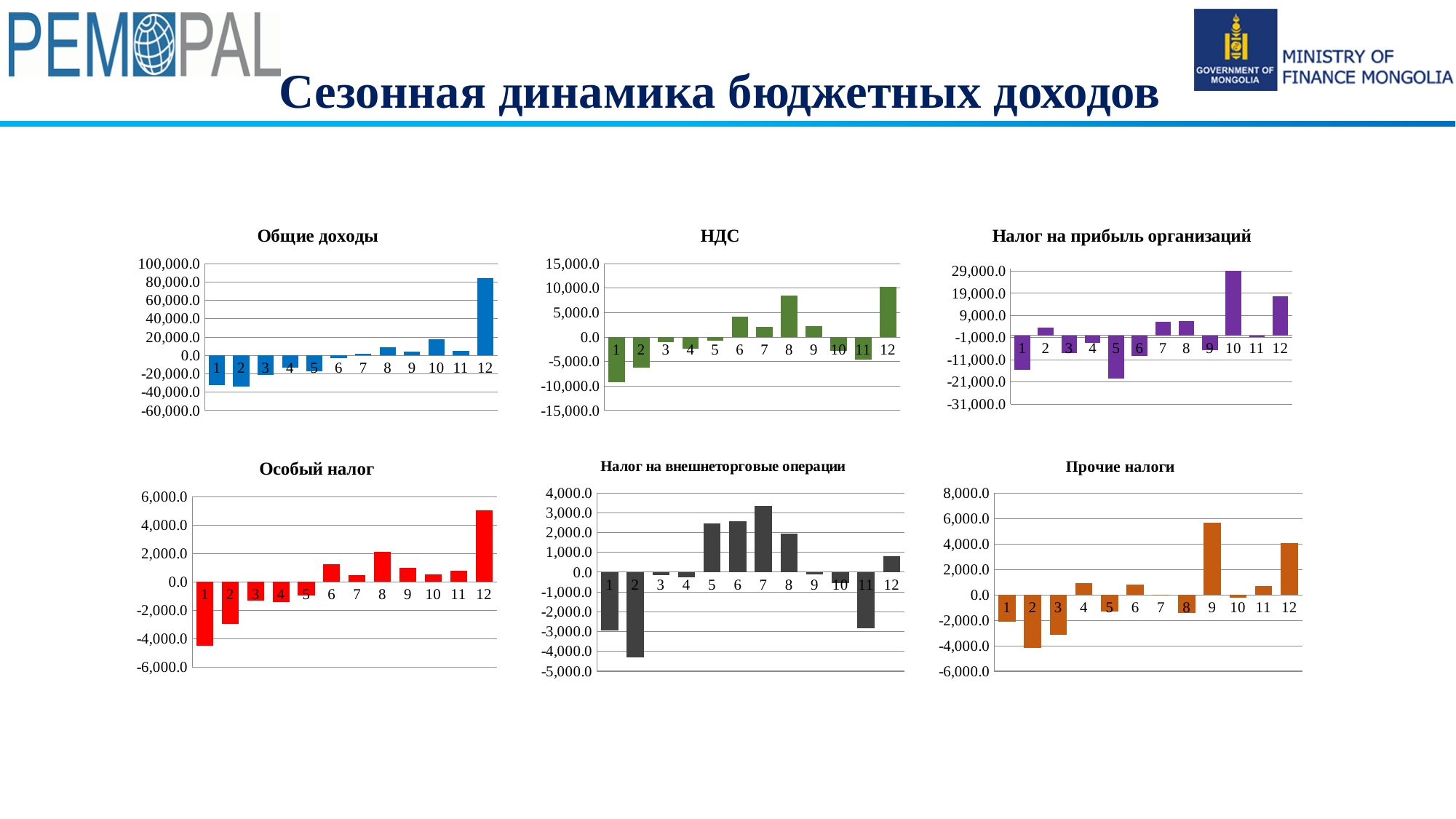
In the 'Налог на прибыль организаций' chart, which category has the highest value? 10 In the 'Налог на внешнеторговые операции' chart, is the value for category 2 greater or less than -4,000.0? less In the 'Налог на внешнеторговые операции' chart, which category has the highest value? 7 In the 'НДС' chart, which category has the lowest value? 1 In the 'Особый налог' chart, is the value for category 12 greater or less than 4,000.0? greater In the 'Налог на прибыль организаций' chart, which category has the lowest value? 5 How many charts are shown on the slide? 6 What kind of chart is the 'Общие доходы' chart? bar chart How many categories are shown on the x axis of the 'НДС' chart? 12 In the 'Прочие налоги' chart, is the value for category 9 greater or less than 4,000.0? greater In the 'Прочие налоги' chart, which is larger, the value for category 9 or category 12? 9 In the 'Общие доходы' chart, which category has the highest value? 12